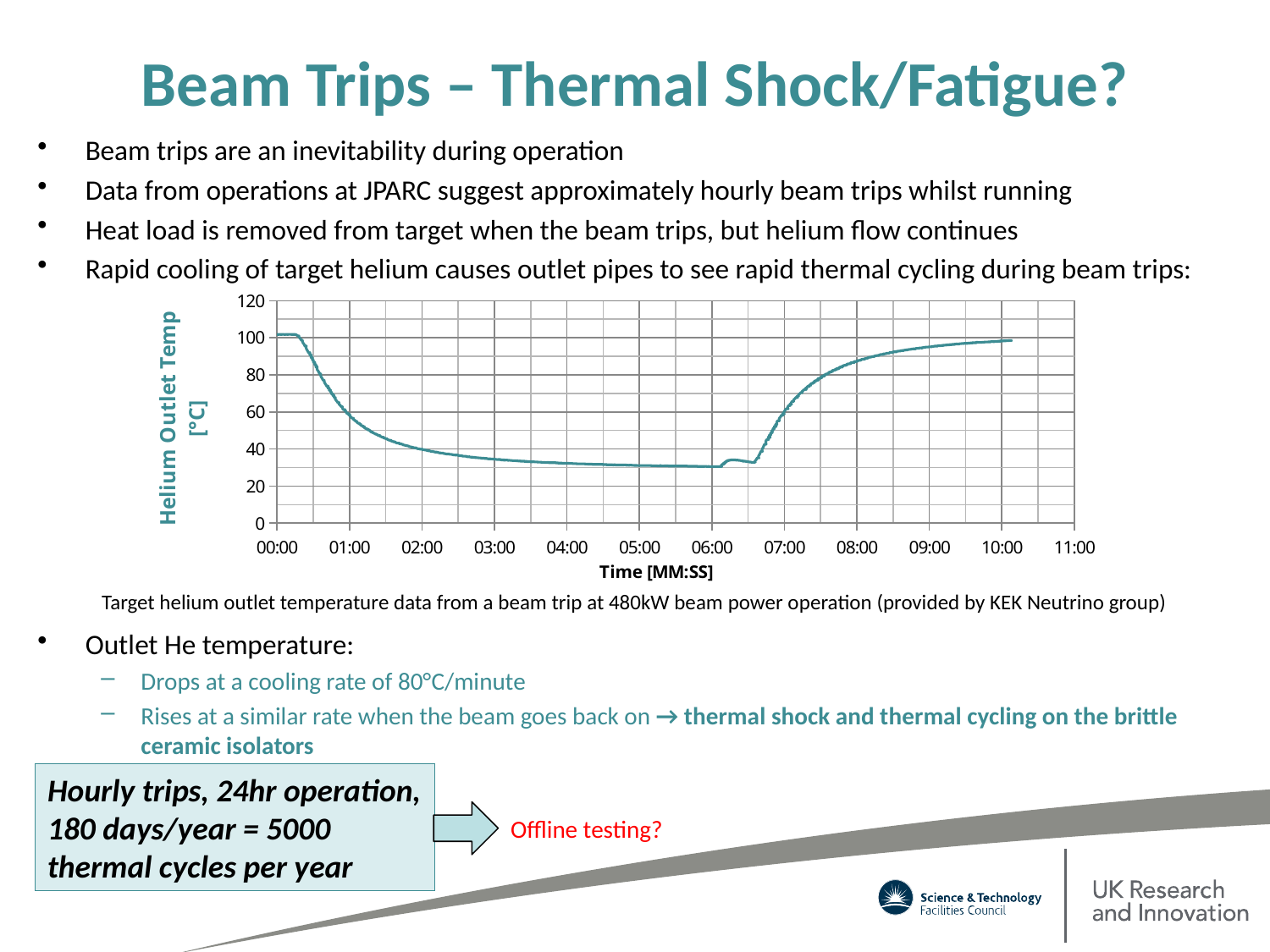
Is the helium outlet temperature at time 00:00 greater or less than 80? greater What kind of chart is shown on the slide? line chart Does the helium outlet temperature rise or fall between 07:00 and 10:00? rise Is the helium outlet temperature at time 03:00 greater or less than 60? less What is the title of the horizontal axis of the chart? Time [MM:SS] Does the helium outlet temperature rise or fall between 00:00 and 05:00? fall Is the helium outlet temperature at time 05:00 greater or less than 40? less Is the helium outlet temperature higher at 01:00 or at 06:00? 01:00 What is the title of the vertical axis of the chart? Helium Outlet Temp [°C] How many data series are plotted on the chart? 1